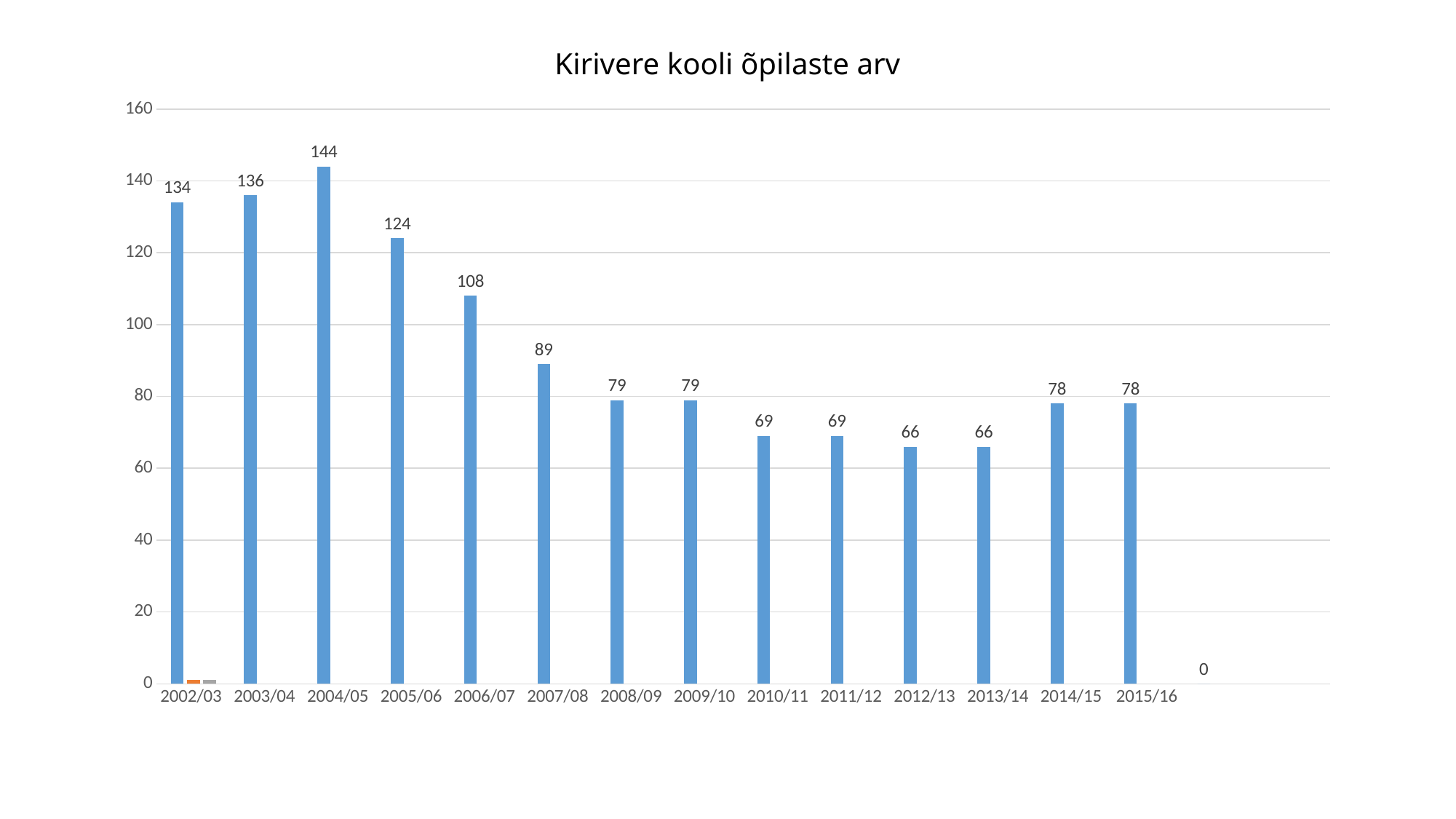
Is the value for 2003/04 greater or less than 120? greater What is the title of the chart? Kirivere kooli õpilaste arv What is the value for 2015/16? 78 What is the value for 2007/08? 89 What type of chart is shown on the slide? bar chart Do the values generally rise or fall from 2004/05 to 2013/14? fall Which is larger, the value for 2006/07 or the value for 2010/11? 2006/07 Which school years have the lowest value among the labelled blue bars? 2012/13 and 2013/14 Which school year has the highest value? 2004/05 How many school years are labelled on the x axis? 14 What is the value for 2004/05? 144 What is the difference between the values for 2004/05 and 2005/06? 20